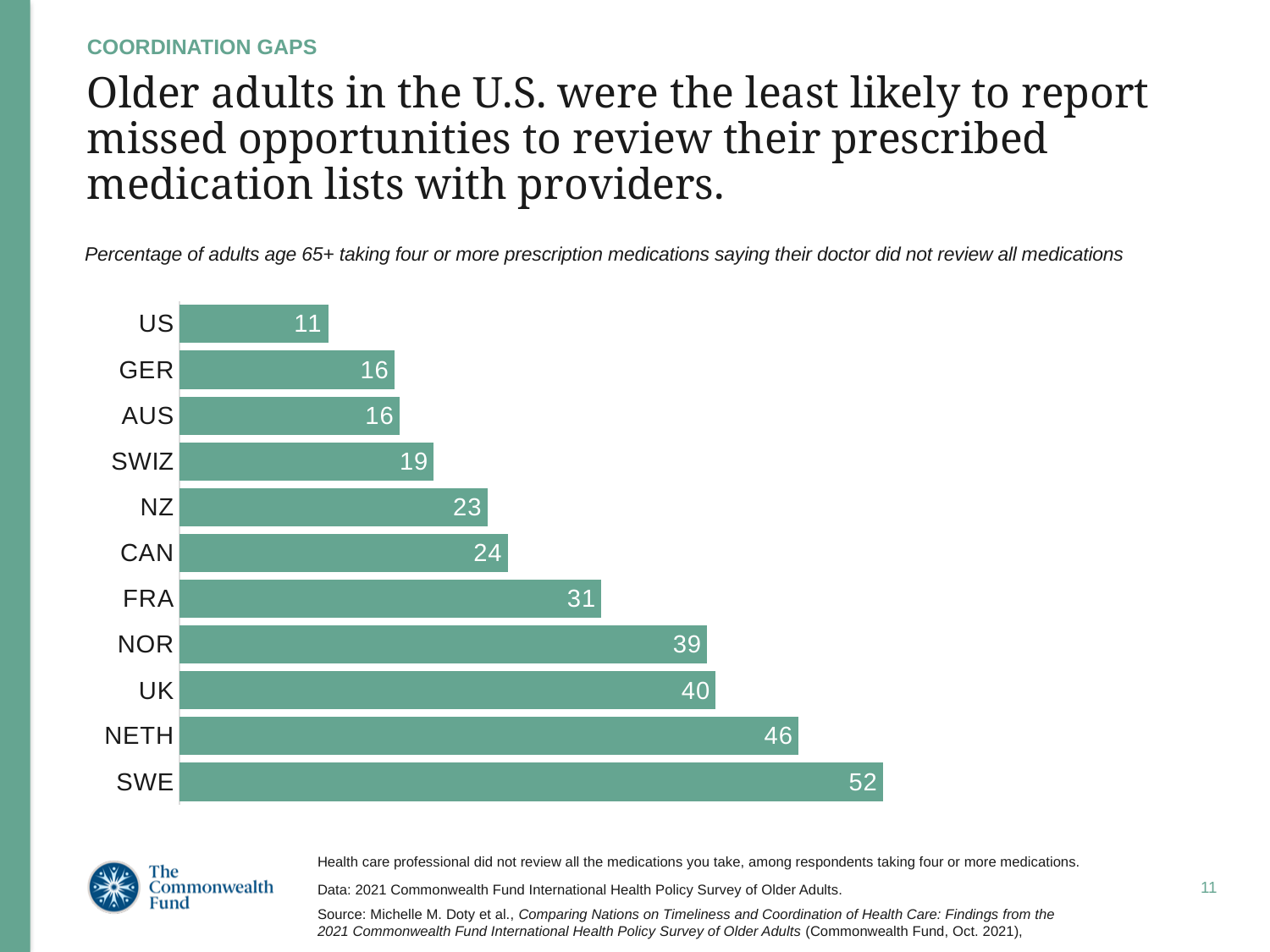
Which country has the lowest value? US What is the value for FRA? 31 What is the value for NETH? 46 What colour are the bars in the chart? Green What is the difference between the values for SWE and US? 41 What is the value for the US? 11 How many countries are shown in the chart? 11 What kind of chart is shown on the slide? Bar chart What is the difference between the values for NOR and CAN? 15 Which is larger, the value for UK or the value for SWIZ? UK Which two countries share the value 16? GER and AUS Which country has the highest value? SWE